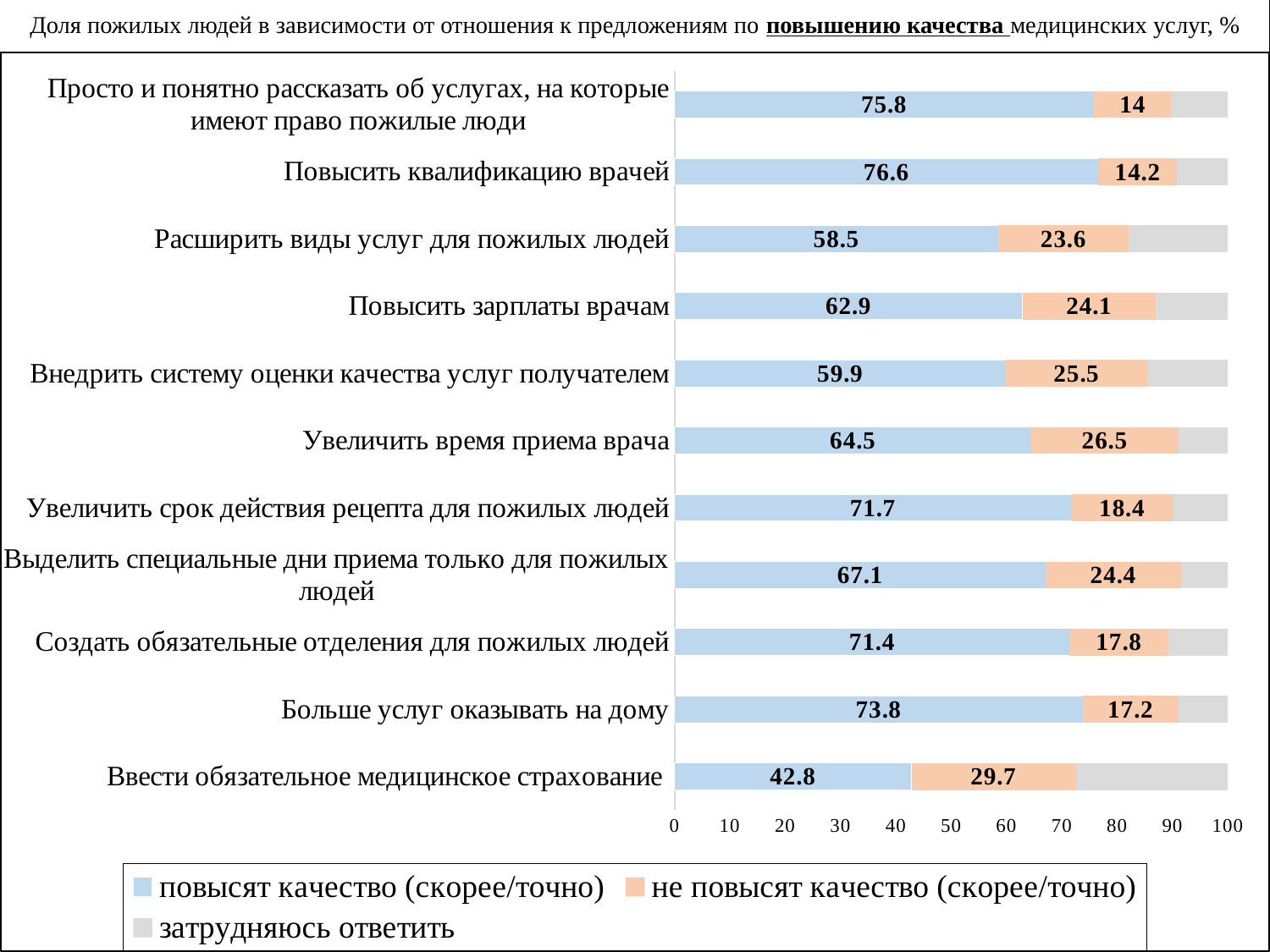
What is the difference between the "повысят качество (скорее/точно)" values for "Просто и понятно рассказать об услугах, на которые имеют право пожилые люди" and "Ввести обязательное медицинское страхование"? 33 How many categories (proposals) are shown in the chart? 11 Which has a larger "повысят качество (скорее/точно)" value: "Увеличить время приема врача" or "Повысить зарплаты врачам"? Увеличить время приема врача Which category has the highest value for "не повысят качество (скорее/точно)"? Ввести обязательное медицинское страхование What kind of chart is shown on the slide? Stacked bar chart What is the value of "не повысят качество (скорее/точно)" for "Ввести обязательное медицинское страхование"? 29.7 What is the value of "не повысят качество (скорее/точно)" for "Расширить виды услуг для пожилых людей"? 23.6 What is the value of "повысят качество (скорее/точно)" for "Повысить квалификацию врачей"? 76.6 How many series does the legend list? 3 Which category has the lowest value for "не повысят качество (скорее/точно)"? Просто и понятно рассказать об услугах, на которые имеют право пожилые люди Which category has the lowest value for "повысят качество (скорее/точно)"? Ввести обязательное медицинское страхование Which category has the highest value for "повысят качество (скорее/точно)"? Повысить квалификацию врачей